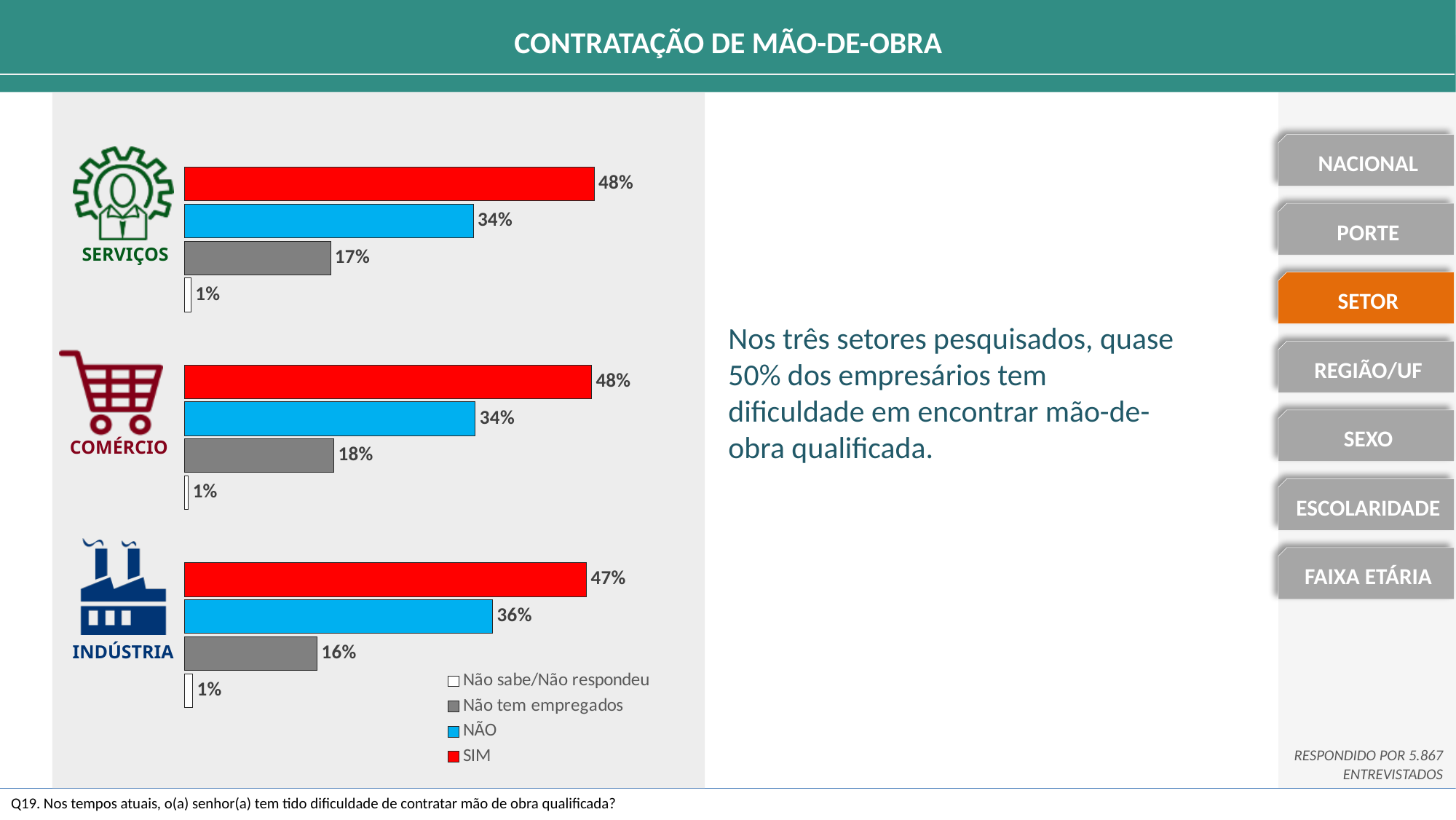
Is the 'Não tem empregados' value larger for COMÉRCIO or for INDÚSTRIA? COMÉRCIO How many series does the legend list? 4 What kind of chart is shown on the slide? Bar chart How many sectors are shown in the chart? 3 What is the SIM value for SERVIÇOS? 48% What is the 'Não tem empregados' value for COMÉRCIO? 18% What is the 'Não sabe/Não respondeu' value for COMÉRCIO? 1% Which sector has the lowest SIM value? INDÚSTRIA What is the difference between the SIM and NÃO values for SERVIÇOS? 14% What is the NÃO value for INDÚSTRIA? 36% Which sector has the highest NÃO value? INDÚSTRIA Which colour represents the SIM series in the legend? Red